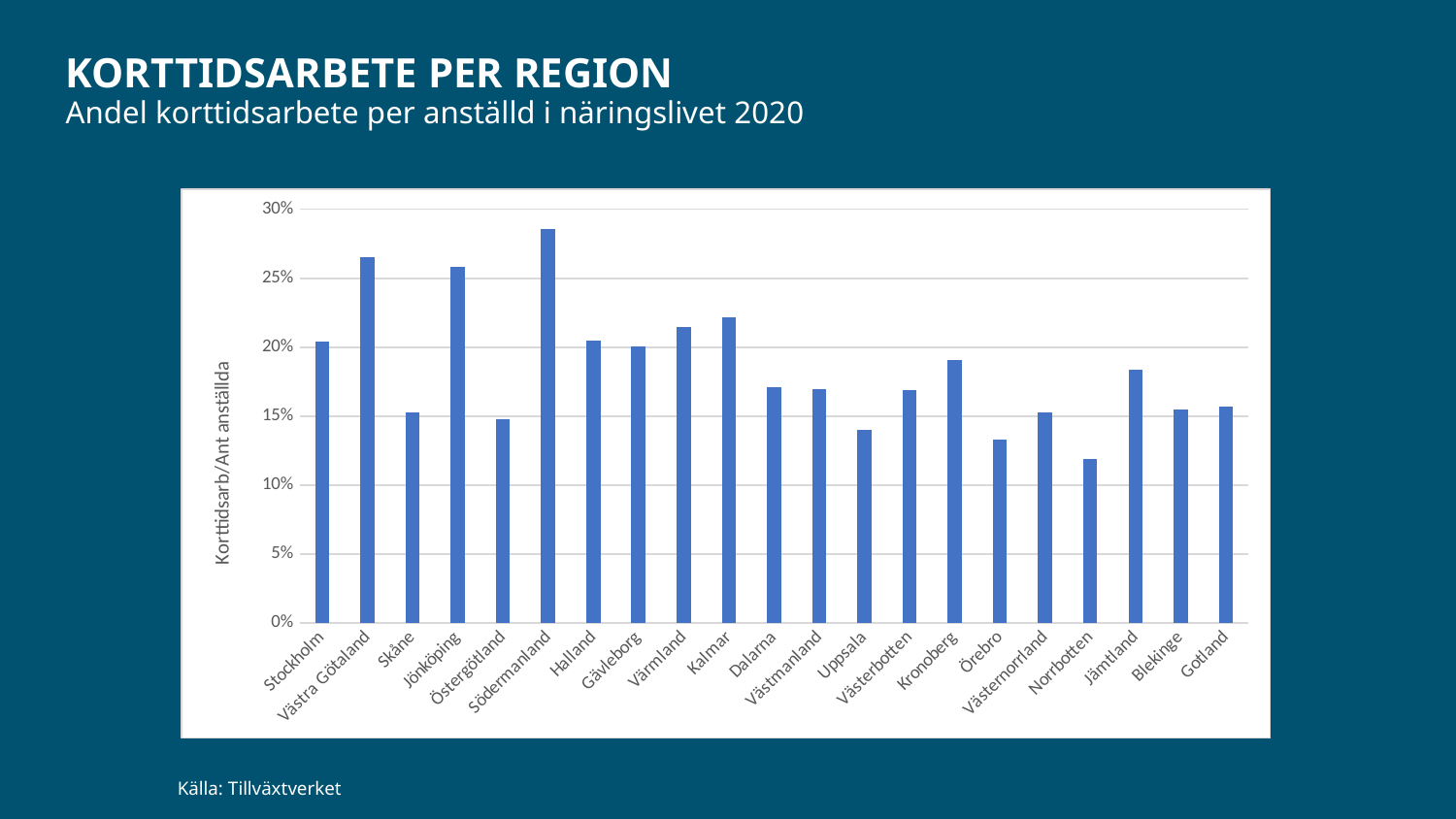
Is the value for Kalmar greater or less than 20%? greater Which has a higher value, Stockholm or Skåne? Stockholm How many regions are shown on the x axis? 21 Is the value for Örebro greater or less than 15%? less What kind of chart is shown on the slide? bar chart Is the value for Norrbotten greater or less than 10%? greater Which has a higher value, Jämtland or Norrbotten? Jämtland Which region has the highest share of korttidsarbete per anställd? Södermanland Which region has the lowest share of korttidsarbete per anställd? Norrbotten What is the label on the y axis of the chart? Korttidsarb/Ant anställda